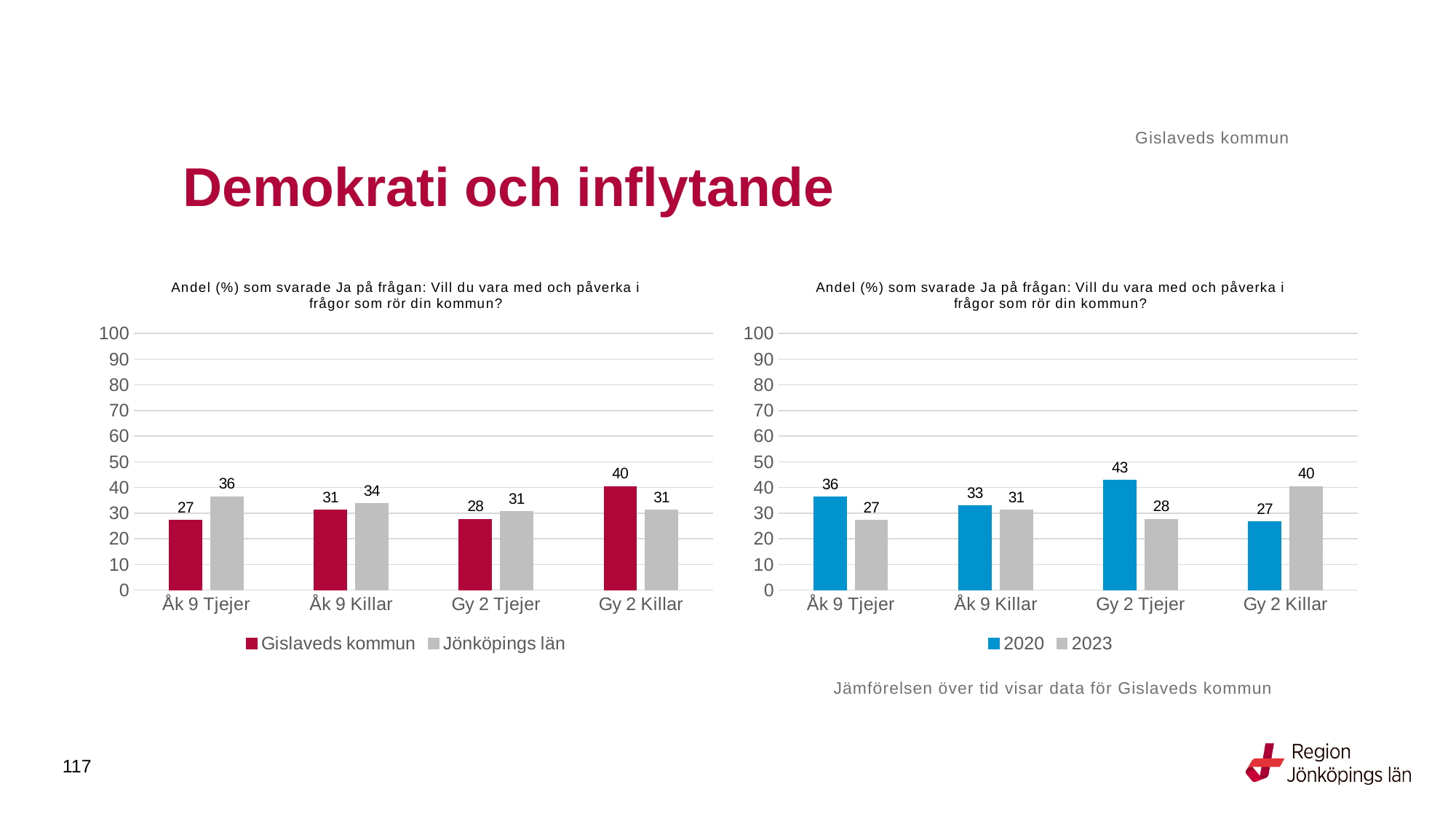
How many series does the legend of the left chart list? 2 In the right chart, what is the value for 2020 for Gy 2 Tjejer? 43 In the right chart, which category has the lowest value for 2023? Åk 9 Tjejer In the left chart, what is the value for Jönköpings län for Åk 9 Tjejer? 36 In the right chart, what is the value for 2023 for Gy 2 Killar? 40 In the right chart, what is the difference between 2020 and 2023 for Gy 2 Tjejer? 15 How many categories are shown on the x axis of the right chart? 4 In the left chart, which is larger for Åk 9 Killar: Gislaveds kommun or Jönköpings län? Jönköpings län What kind of chart is the right chart? Bar chart In the left chart, which category has the highest value for Gislaveds kommun? Gy 2 Killar In the left chart, what is the value for Gislaveds kommun for Gy 2 Killar? 40 In the left chart, what is the difference between Gislaveds kommun and Jönköpings län for Gy 2 Killar? 9